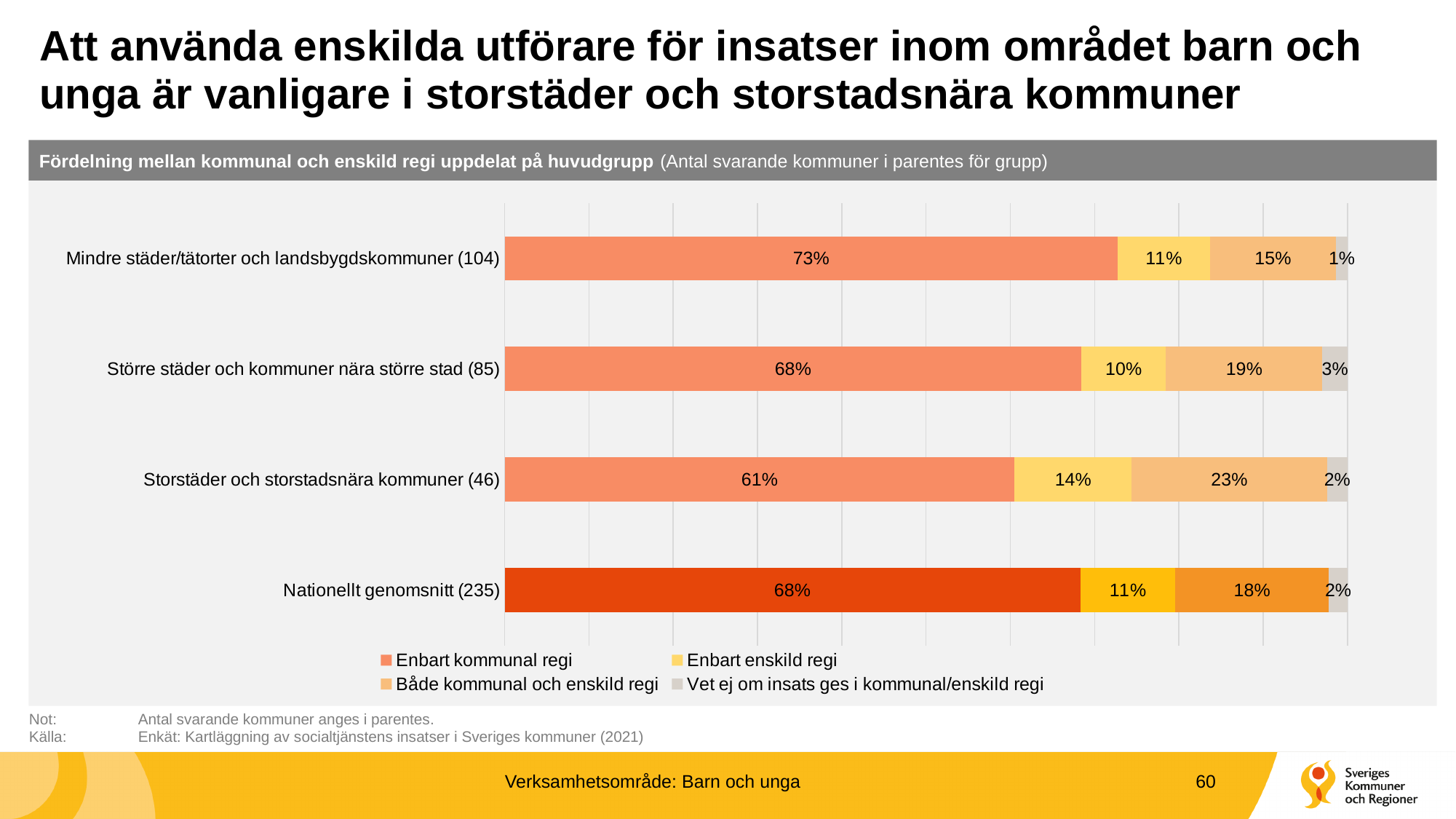
What is the value for "Enbart enskild regi" for "Större städer och kommuner nära större stad (85)"? 10% How many categories (bars) are shown in the chart? 4 How many series does the legend list? 4 What kind of chart is shown on the slide? Stacked bar chart What is the value for "Vet ej om insats ges i kommunal/enskild regi" for "Nationellt genomsnitt (235)"? 2% Which is larger: the "Enbart enskild regi" value for "Storstäder och storstadsnära kommuner (46)" or for "Nationellt genomsnitt (235)"? Storstäder och storstadsnära kommuner (46) What is the value for "Enbart kommunal regi" for "Mindre städer/tätorter och landsbygdskommuner (104)"? 73% Which category has the highest value for "Enbart kommunal regi"? Mindre städer/tätorter och landsbygdskommuner (104) Which category has the lowest value for "Både kommunal och enskild regi"? Mindre städer/tätorter och landsbygdskommuner (104) What is the value for "Både kommunal och enskild regi" for "Storstäder och storstadsnära kommuner (46)"? 23% What is the difference between the "Enbart kommunal regi" values for "Mindre städer/tätorter och landsbygdskommuner (104)" and "Storstäder och storstadsnära kommuner (46)"? 12 percentage points What is the total of the stacked bar for "Mindre städer/tätorter och landsbygdskommuner (104)"? 100%